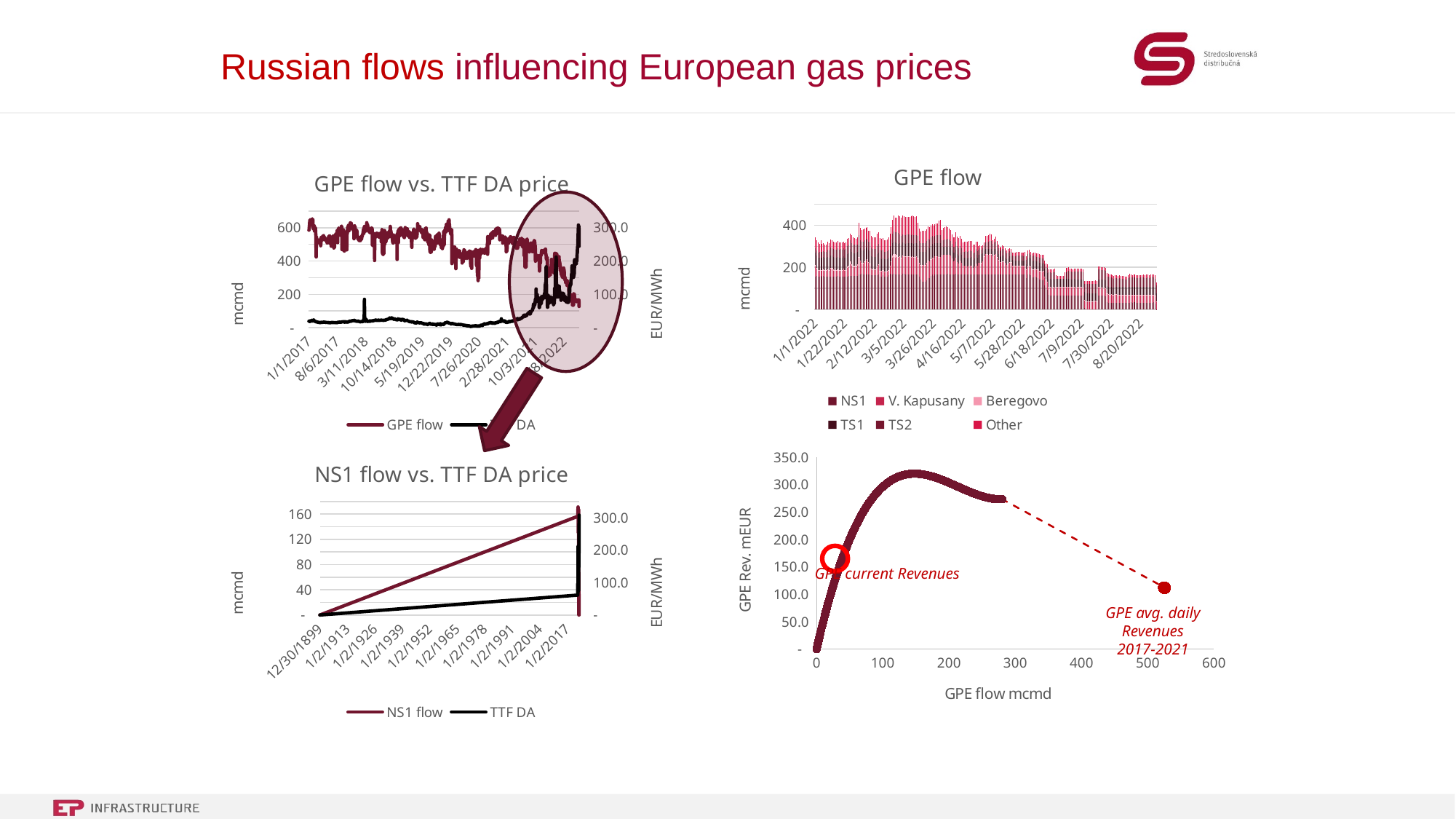
What unit is shown on the left vertical axis of the 'GPE flow vs. TTF DA price' chart? mcmd What kind of chart is 'GPE flow vs. TTF DA price'? line chart In the bottom-right chart (GPE Rev. mEUR vs. GPE flow mcmd), is the peak of the plotted revenue curve greater or less than 300.0? greater What kind of chart is the 'GPE flow' chart at the top right of the slide? bar chart In the bottom-right chart (GPE Rev. mEUR vs. GPE flow mcmd), is the GPE flow value of the 'GPE avg. daily Revenues 2017-2021' point greater or less than 500? greater What unit is shown on the right vertical axis of the 'NS1 flow vs. TTF DA price' chart? EUR/MWh How many series does the legend of the 'NS1 flow vs. TTF DA price' chart list? 2 In the 'GPE flow' chart, do the stacked totals generally rise or fall from 1/1/2022 to 8/20/2022? fall In the 'GPE flow' chart, is the total value at 1/1/2022 greater or less than 200? greater How many series does the legend of the 'GPE flow' chart list? 6 In the 'GPE flow vs. TTF DA price' chart, does the GPE flow series generally rise or fall from 1/1/2017 to 2022? fall